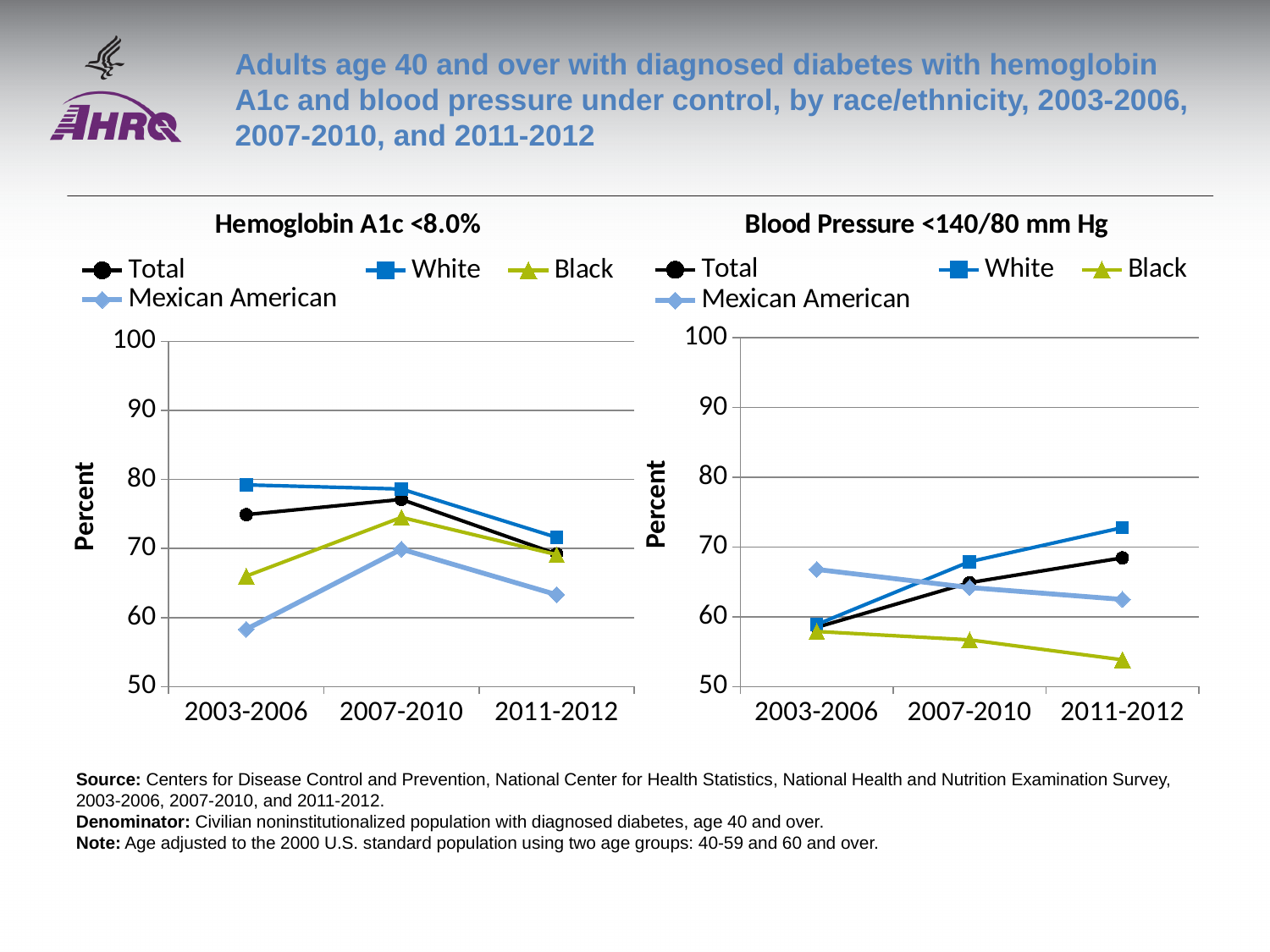
In the Hemoglobin A1c <8.0% chart, which group has the lowest value in 2003-2006? Mexican American In the Blood Pressure <140/80 mm Hg chart, do the values for White rise or fall from 2003-2006 to 2011-2012? rise In the Hemoglobin A1c <8.0% chart, which is larger in 2003-2006, White or Black? White How many series does the legend of the Blood Pressure <140/80 mm Hg chart list? 4 In the Blood Pressure <140/80 mm Hg chart, do the values for Black rise or fall from 2003-2006 to 2011-2012? fall In the Hemoglobin A1c <8.0% chart, which group has the highest value in 2003-2006? White In the Blood Pressure <140/80 mm Hg chart, which group has the highest value in 2011-2012? White How many time periods are shown on the x axis of the Hemoglobin A1c <8.0% chart? 3 In the Blood Pressure <140/80 mm Hg chart, is the value for White in 2011-2012 greater or less than 70? greater In the Blood Pressure <140/80 mm Hg chart, which group has the lowest value in 2011-2012? Black What kind of chart is the Hemoglobin A1c <8.0% chart on the left? line chart In the Hemoglobin A1c <8.0% chart, is the value for Mexican American in 2003-2006 greater or less than 60? less